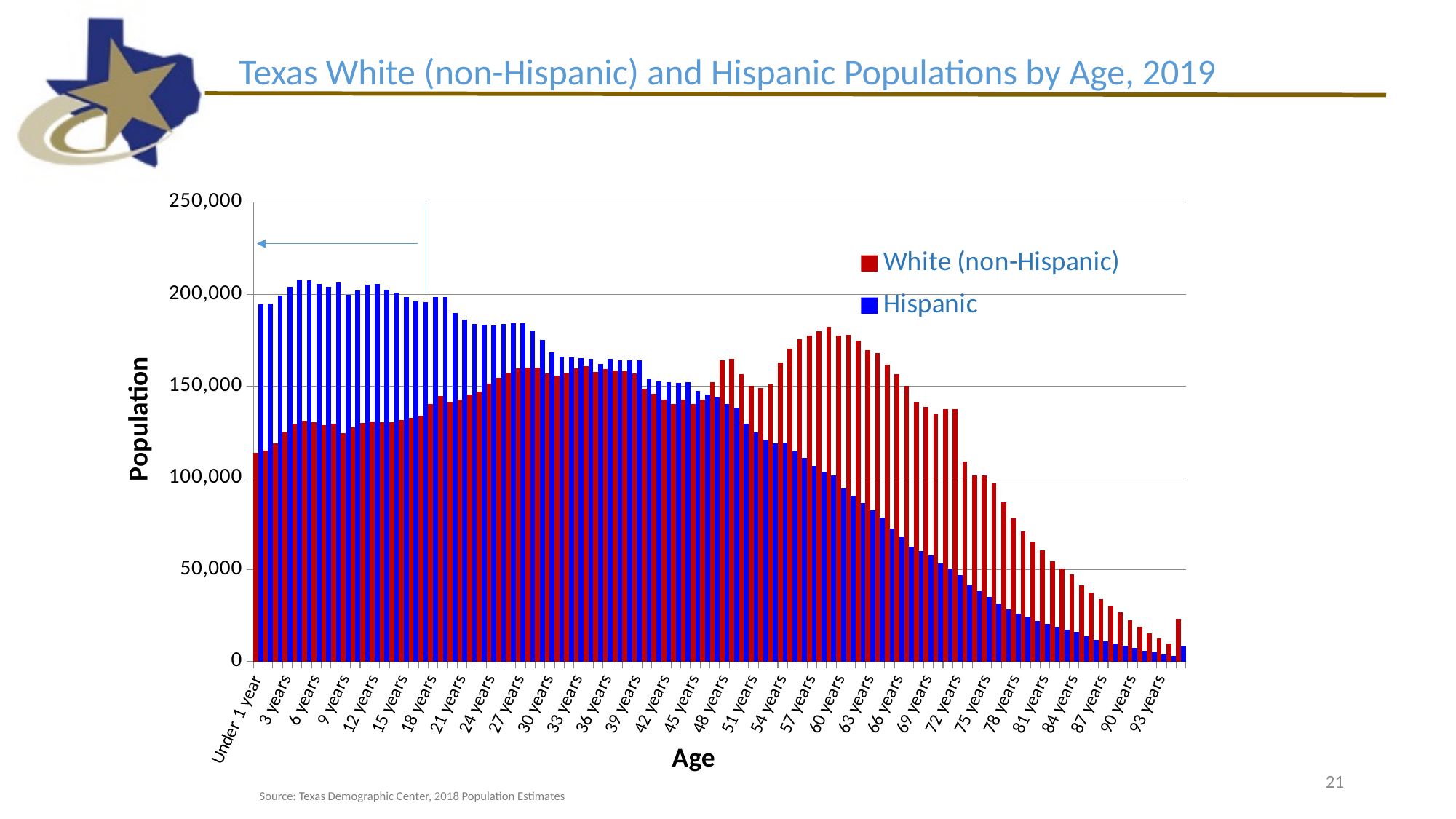
At 6 years, which series has the larger value, White (non-Hispanic) or Hispanic? Hispanic Is the White (non-Hispanic) value for 60 years greater or less than 150,000? greater Is the White (non-Hispanic) value for Under 1 year greater or less than 150,000? less Do the White (non-Hispanic) values generally rise or fall from 60 years to 93 years? fall Which series is shown in blue? Hispanic What kind of chart is shown on the slide? bar chart Is the Hispanic value for Under 1 year greater or less than 150,000? greater How many series does the legend list? 2 What is the title of the vertical axis? Population At 60 years, which series has the larger value, White (non-Hispanic) or Hispanic? White (non-Hispanic)